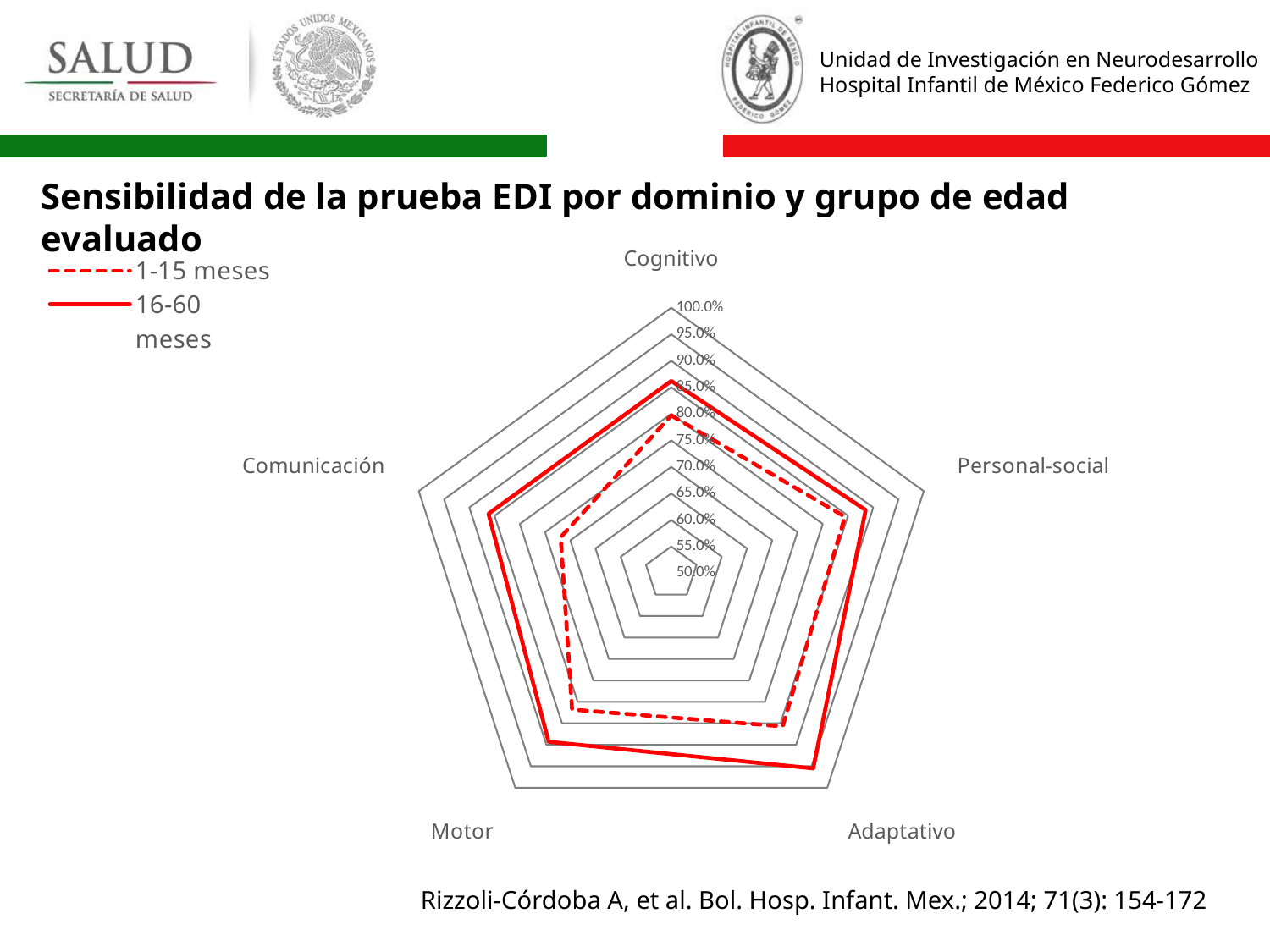
What kind of chart is shown on the slide? Radar chart For Motor, which series has the larger value, 1-15 meses or 16-60 meses? 16-60 meses For Comunicación, which series has the larger value, 1-15 meses or 16-60 meses? 16-60 meses How many series does the legend list? 2 Is the value for Comunicación in the 1-15 meses series greater or less than 80.0%? less Is the value for Cognitivo in the 16-60 meses series greater or less than 80.0%? greater How many domains (axes) does the radar chart have? 5 What is the highest value shown on the chart's axis scale? 100.0% Is the value for Cognitivo in the 1-15 meses series greater or less than 90.0%? less Which series is drawn with a dashed line? 1-15 meses In the 1-15 meses series, which domain has the lowest value? Comunicación